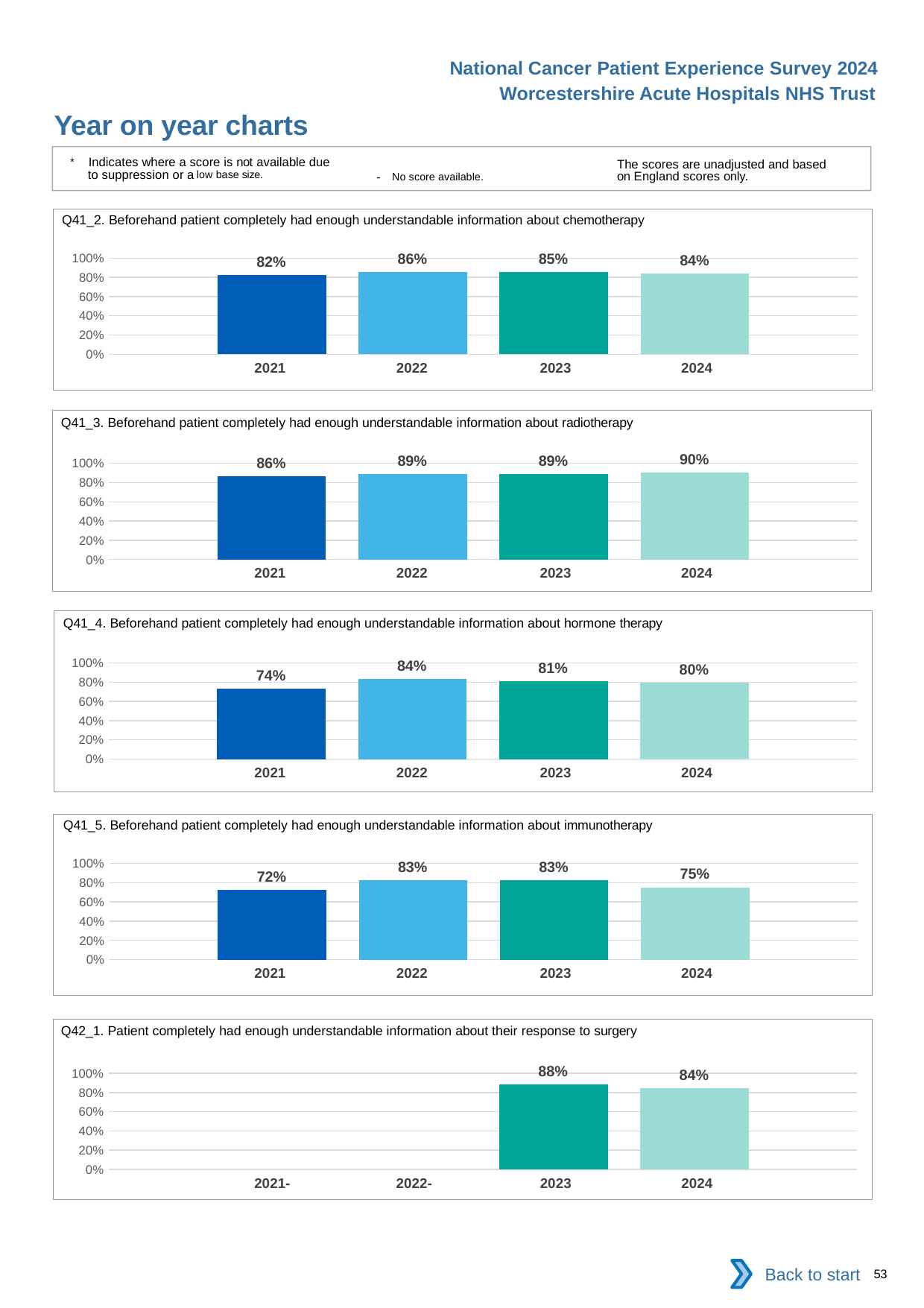
In the Q41_2 chemotherapy chart, what is the difference between the 2021 and 2022 values? 4% In the Q41_3 radiotherapy chart, do the values rise or fall from 2021 to 2024? Rise In the Q41_5 immunotherapy chart, what is the value for 2021? 72% In the Q41_5 immunotherapy chart, what is the difference between the 2023 and 2024 values? 8% In the Q41_2 chemotherapy chart, what is the value for 2022? 86% In the Q41_4 hormone therapy chart, which year has the lowest value? 2021 In the Q41_2 chemotherapy chart, how many years have bars plotted? 4 In the Q41_3 radiotherapy chart, which year has the highest value? 2024 What type of chart is the Q41_3 radiotherapy chart? Bar chart In the Q42_1 surgery chart, how many years have bars plotted? 2 In the Q41_4 hormone therapy chart, which is larger, the value for 2022 or the value for 2024? 2022 In the Q42_1 surgery chart, what is the value for 2023? 88%